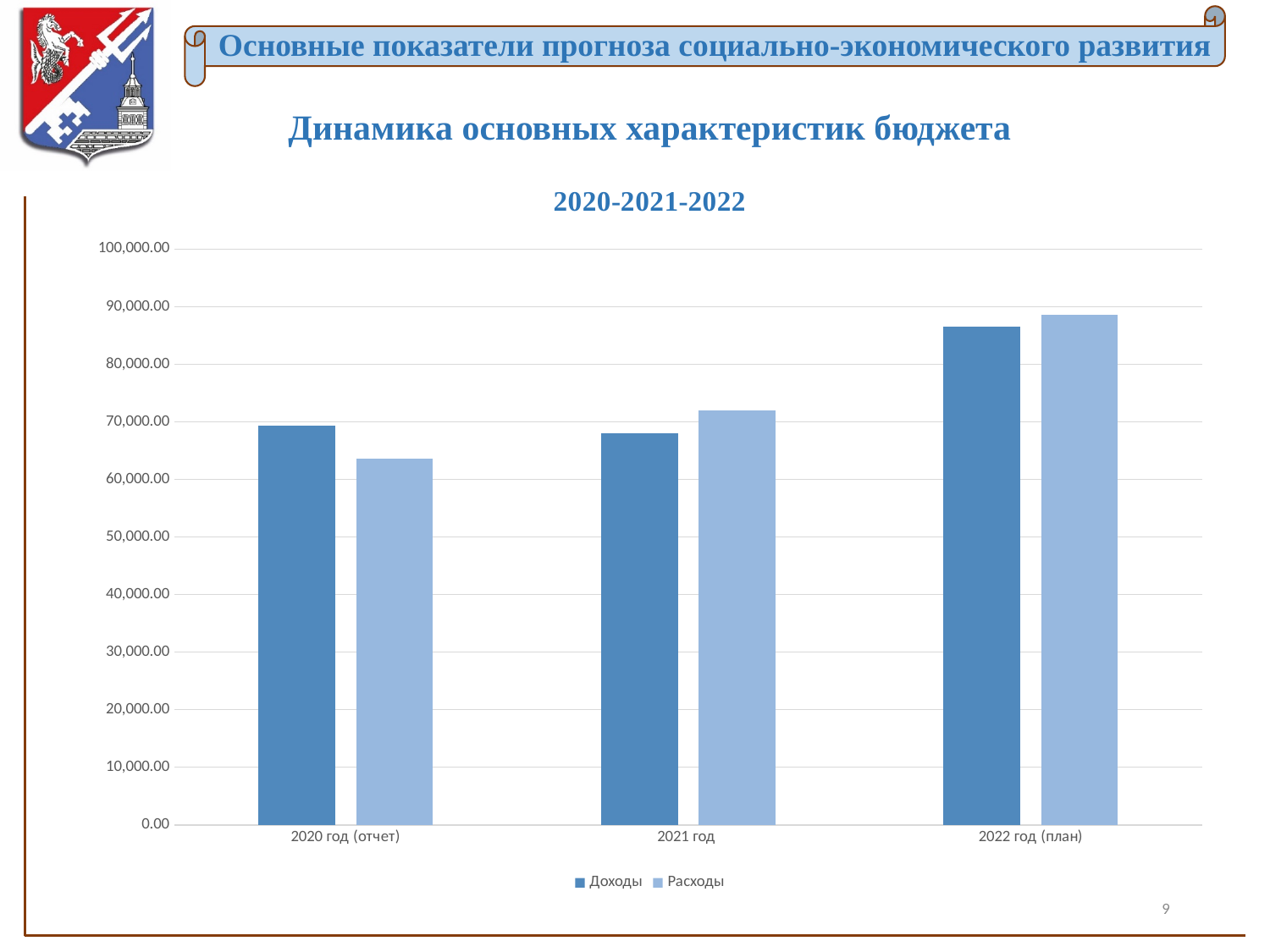
Which year has the lowest value for Расходы? 2020 год (отчет) What kind of chart is shown on the slide? Bar chart How many year categories are shown on the x axis of the chart? 3 Is the value for Доходы in 2022 год (план) greater or less than 80,000.00? greater In 2020 год (отчет), which is larger, Доходы or Расходы? Доходы Is the value for Доходы in 2020 год (отчет) greater or less than 60,000.00? greater What are the two series named in the chart legend? Доходы and Расходы What is the title shown above the chart? 2020-2021-2022 In 2021 год, which is larger, Доходы or Расходы? Расходы Is the value for Расходы in 2020 год (отчет) greater or less than 70,000.00? less How many series does the chart legend list? 2